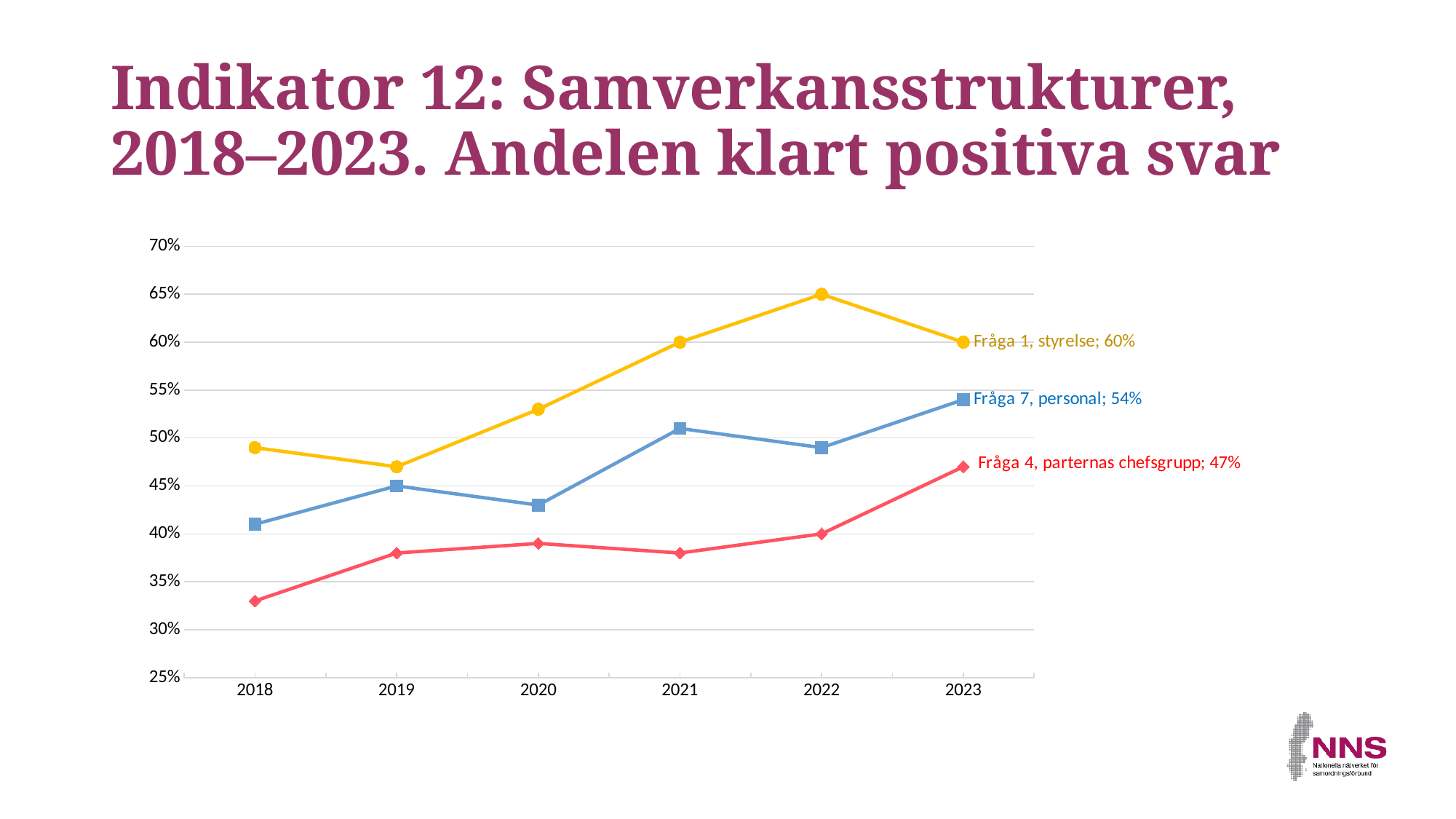
Is the value for Fråga 1, styrelse in 2022 greater or less than 60%? greater What is the value for Fråga 4, parternas chefsgrupp in 2023? 47% Is the value for Fråga 4, parternas chefsgrupp in 2018 greater or less than 35%? less What is the value for Fråga 1, styrelse in 2023? 60% What kind of chart is shown on the slide? line chart Does the value for Fråga 4, parternas chefsgrupp rise or fall from 2018 to 2023? rise In 2023, which is larger: Fråga 7, personal or Fråga 4, parternas chefsgrupp? Fråga 7, personal Which series has the highest value in 2023? Fråga 1, styrelse What is the value for Fråga 7, personal in 2023? 54% How many years are shown on the x axis? 6 How many series are plotted on the chart? 3 What is the difference between the 2023 values for Fråga 1, styrelse and Fråga 4, parternas chefsgrupp? 13 percentage points